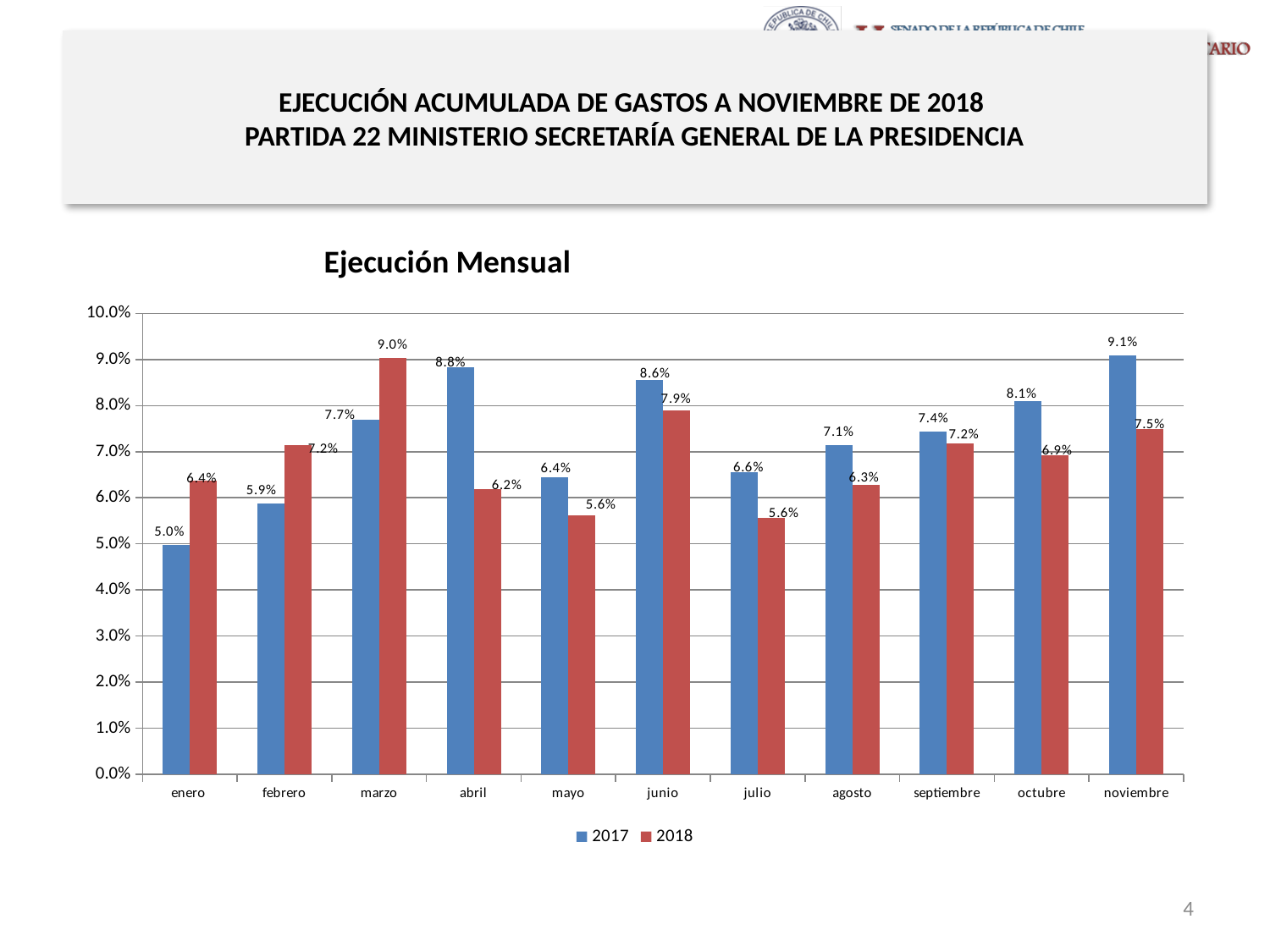
What is the 2018 value for octubre? 6.9% Is the 2017 value for noviembre greater or less than 9.0%? greater What is the 2017 value for abril? 8.8% What is the 2018 value for marzo? 9.0% What type of chart is shown? Bar chart Which month has the lowest 2017 value? enero How many series does the legend list? 2 Which month has the highest 2017 value? noviembre How many months are shown on the x axis? 11 What is the difference between the 2018 and 2017 values for marzo? 1.3 percentage points Which month has the highest 2018 value? marzo Which is larger in abril, the 2017 value or the 2018 value? 2017